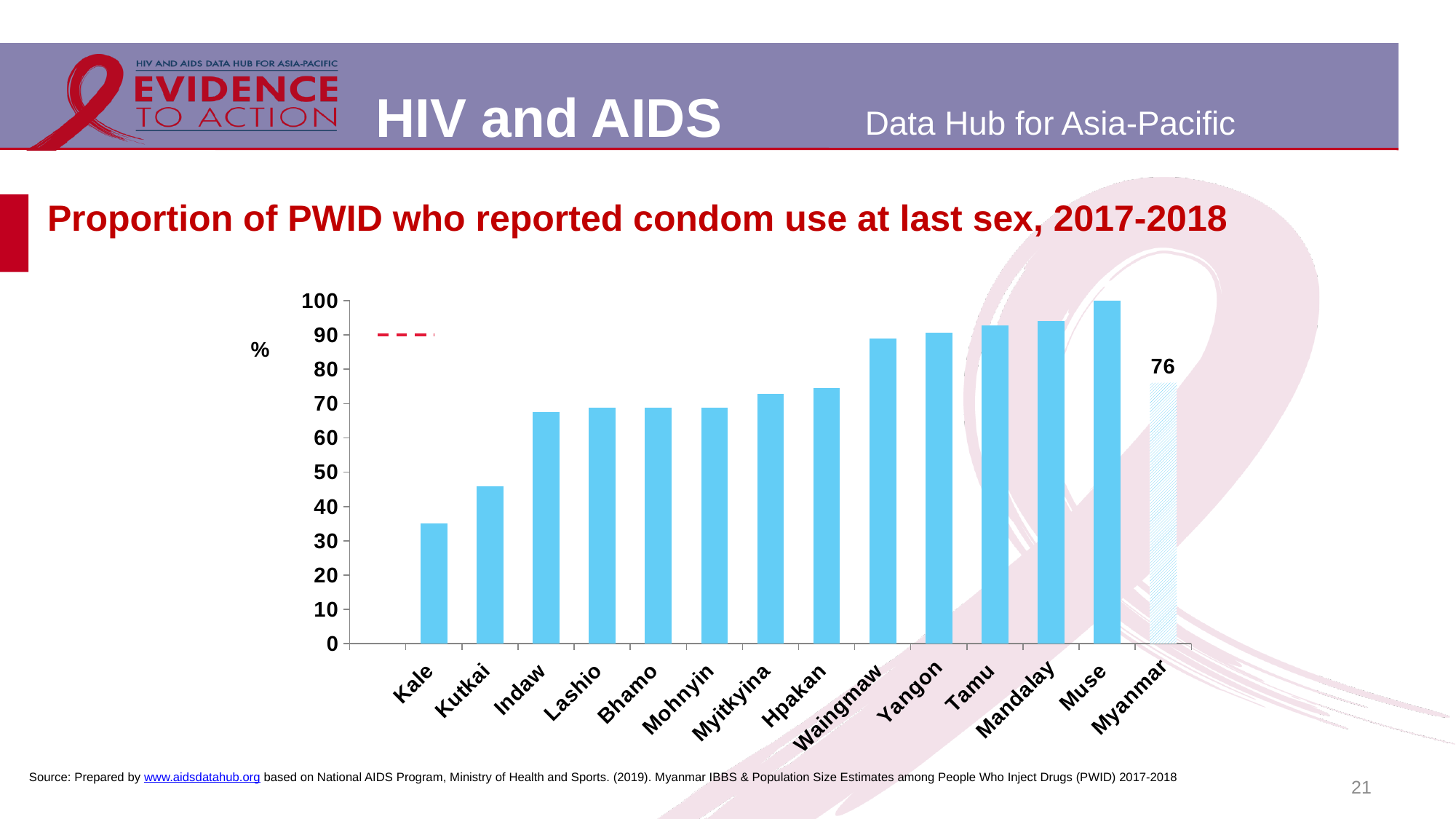
Is the value for Waingmaw greater or less than 80? greater What is the value for Myanmar? 76 How many categories are shown on the x axis? 14 What kind of chart is shown on the slide? Bar chart What is the title of the chart? Proportion of PWID who reported condom use at last sex, 2017-2018 Do the values rise or fall along the x axis from Kale to Muse? rise Is the value for Kutkai greater or less than 50? less Which is larger, the value for Kutkai or the value for Indaw? Indaw Which category has the highest bar? Muse Is the value for Hpakan greater or less than 80? less Which category has the lowest bar? Kale